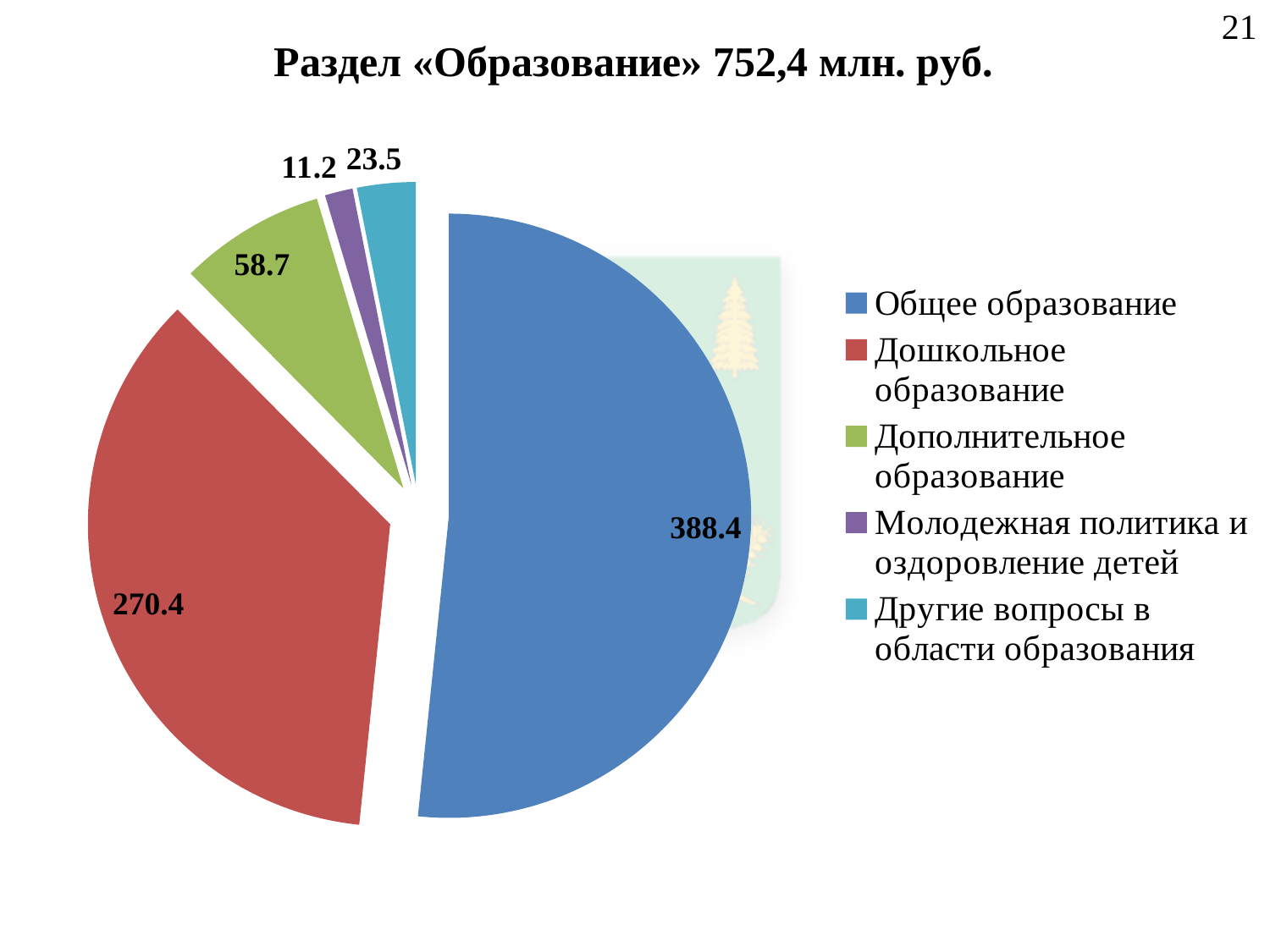
Which category has the smallest slice of the pie? Молодежная политика и оздоровление детей What is the title of the chart? Раздел «Образование» 752,4 млн. руб. What is the value for Общее образование? 388.4 What is the value for Молодежная политика и оздоровление детей? 11.2 What is the difference between the values for Общее образование and Дошкольное образование? 118 Which category has the largest slice of the pie? Общее образование What is the value for Дошкольное образование? 270.4 Which is larger: Дополнительное образование or Другие вопросы в области образования? Дополнительное образование What is the value for Другие вопросы в области образования? 23.5 What type of chart is shown on the slide? pie chart What is the value for Дополнительное образование? 58.7 How many categories does the pie chart have? 5